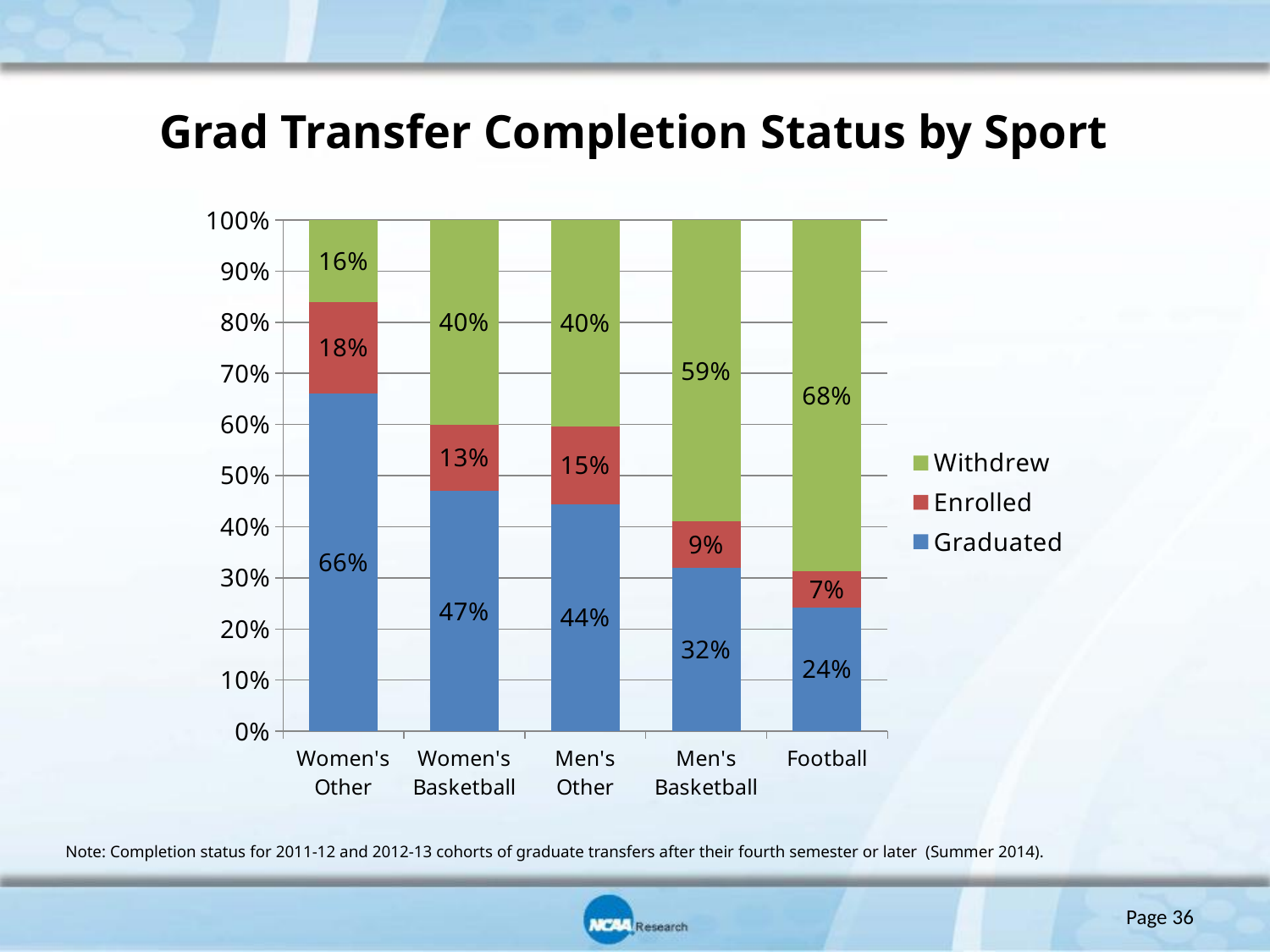
How many series does the legend list? 3 How many sport categories are shown on the x axis? 5 Which is larger, the Enrolled value for Women's Other or the Enrolled value for Football? Women's Other Which sport has the highest Graduated percentage? Women's Other What percentage of Women's Other grad transfers graduated? 66% What is the Enrolled value for Men's Basketball? 9% What is the difference between the Graduated percentages for Women's Basketball and Men's Basketball? 15% What kind of chart is shown on the slide? Stacked bar chart Which sport has the lowest Withdrew percentage? Women's Other Does the Graduated percentage rise or fall moving from Women's Other to Football along the x axis? Fall What is the title of the chart? Grad Transfer Completion Status by Sport What is the Withdrew value for Football? 68%